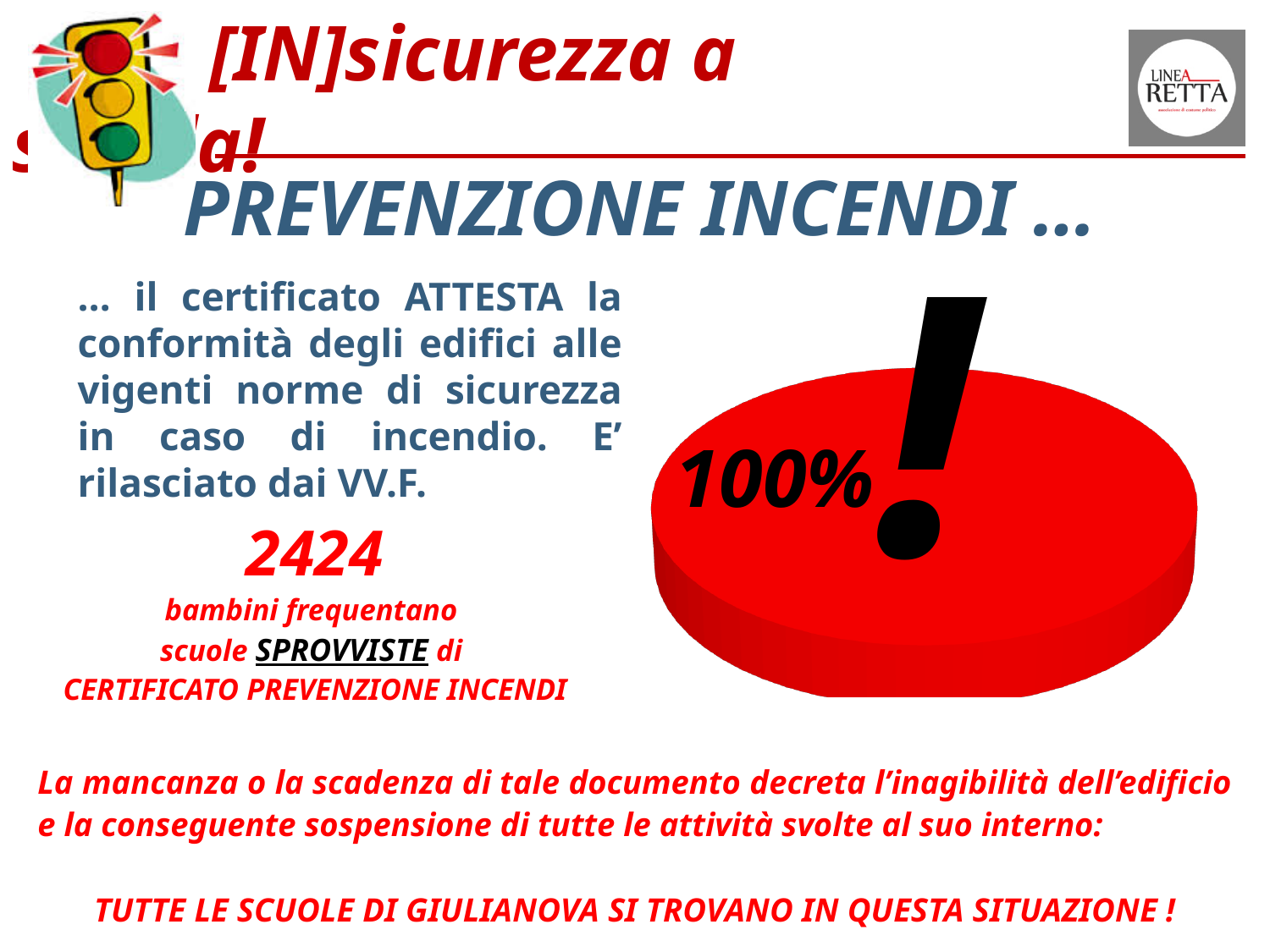
What kind of chart is shown on the right side of the slide? pie chart What share of the pie does the single slice represent? 100% What percentage is printed on the pie chart? 100% Is the value shown on the pie chart greater or less than 50%? greater How many slices does the pie chart have? 1 What colour is the pie chart? red